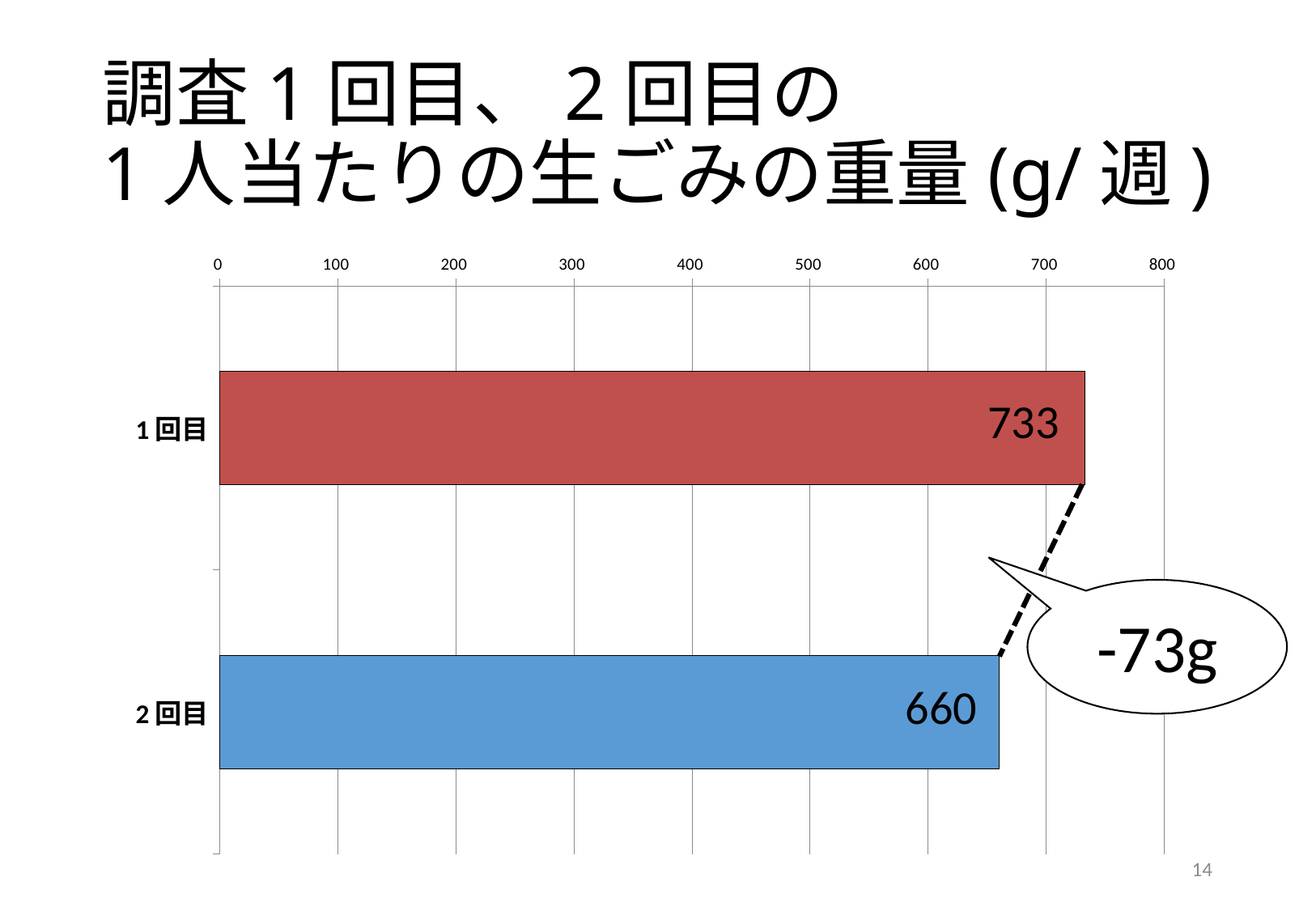
Which is larger, the value for 1回目 or the value for 2回目? 1回目 What is the value for 2回目? 660 What is the value for 1回目? 733 What kind of chart is shown on the slide? bar chart How many categories are shown in the chart? 2 What colour is the bar for 2回目? blue Is the value for 2回目 greater or less than 700? less Which category has the lowest value? 2回目 What is the difference between the values for 1回目 and 2回目? 73 What does the callout on the chart say? -73g Which category has the highest value? 1回目 Is the value for 1回目 greater or less than 700? greater